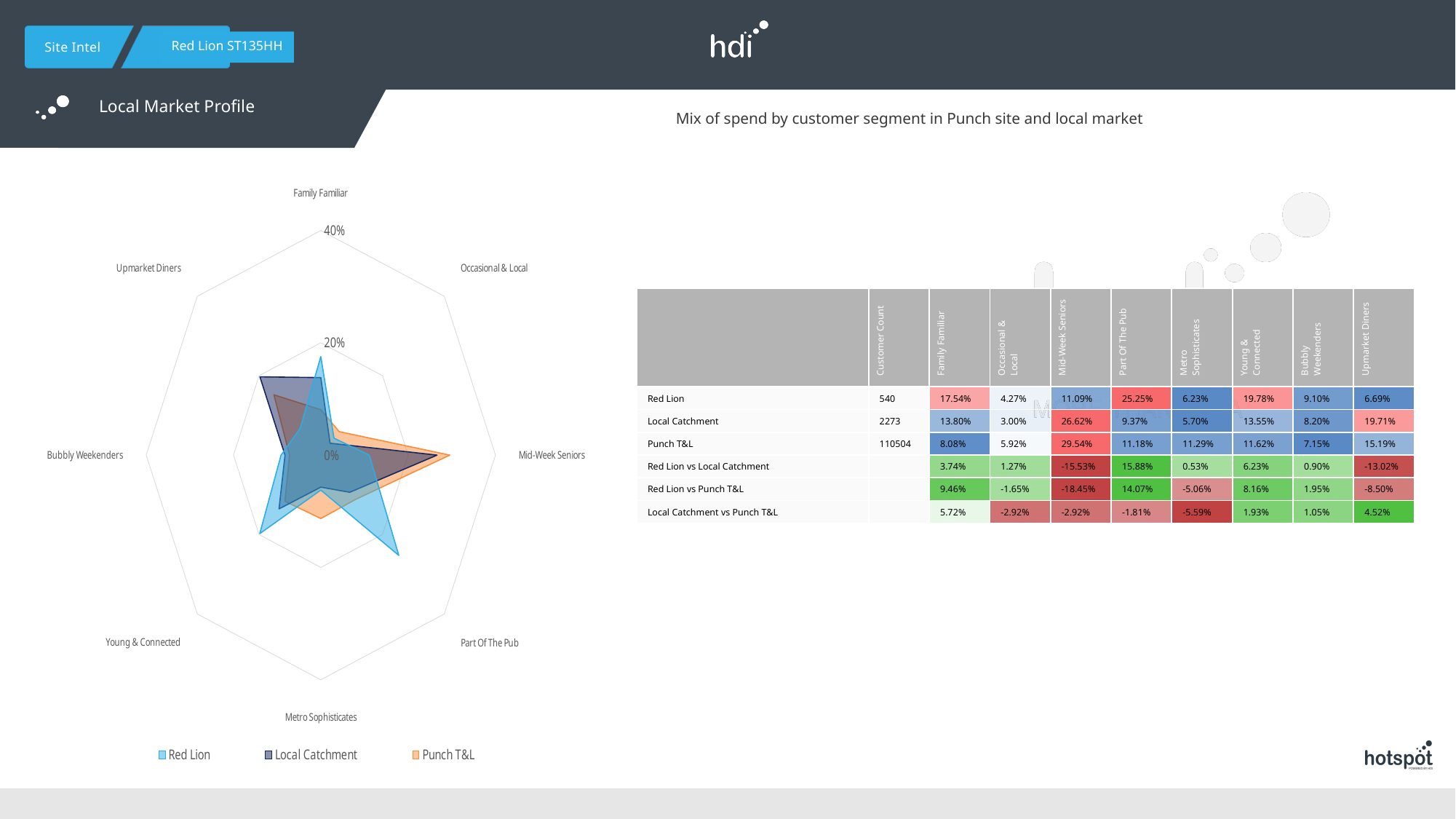
What is the Punch T&L value for Mid-Week Seniors? 29.54% What is the Red Lion value for Part Of The Pub? 25.25% Which segment has the lowest value for the Red Lion series? Occasional & Local Is the Red Lion value for Part Of The Pub greater or less than 20%? greater What is the difference between the Red Lion and Local Catchment values for Part Of The Pub? 15.88% For Part Of The Pub, which is larger: Red Lion or Local Catchment? Red Lion What kind of chart is shown on the left of the slide? Radar chart What is the Local Catchment value for Upmarket Diners? 19.71% Which series are listed in the radar chart's legend? Red Lion, Local Catchment, Punch T&L How many series does the radar chart's legend list? 3 Which segment has the highest value for the Red Lion series? Part Of The Pub How many customer segments (axes) does the radar chart have? 8